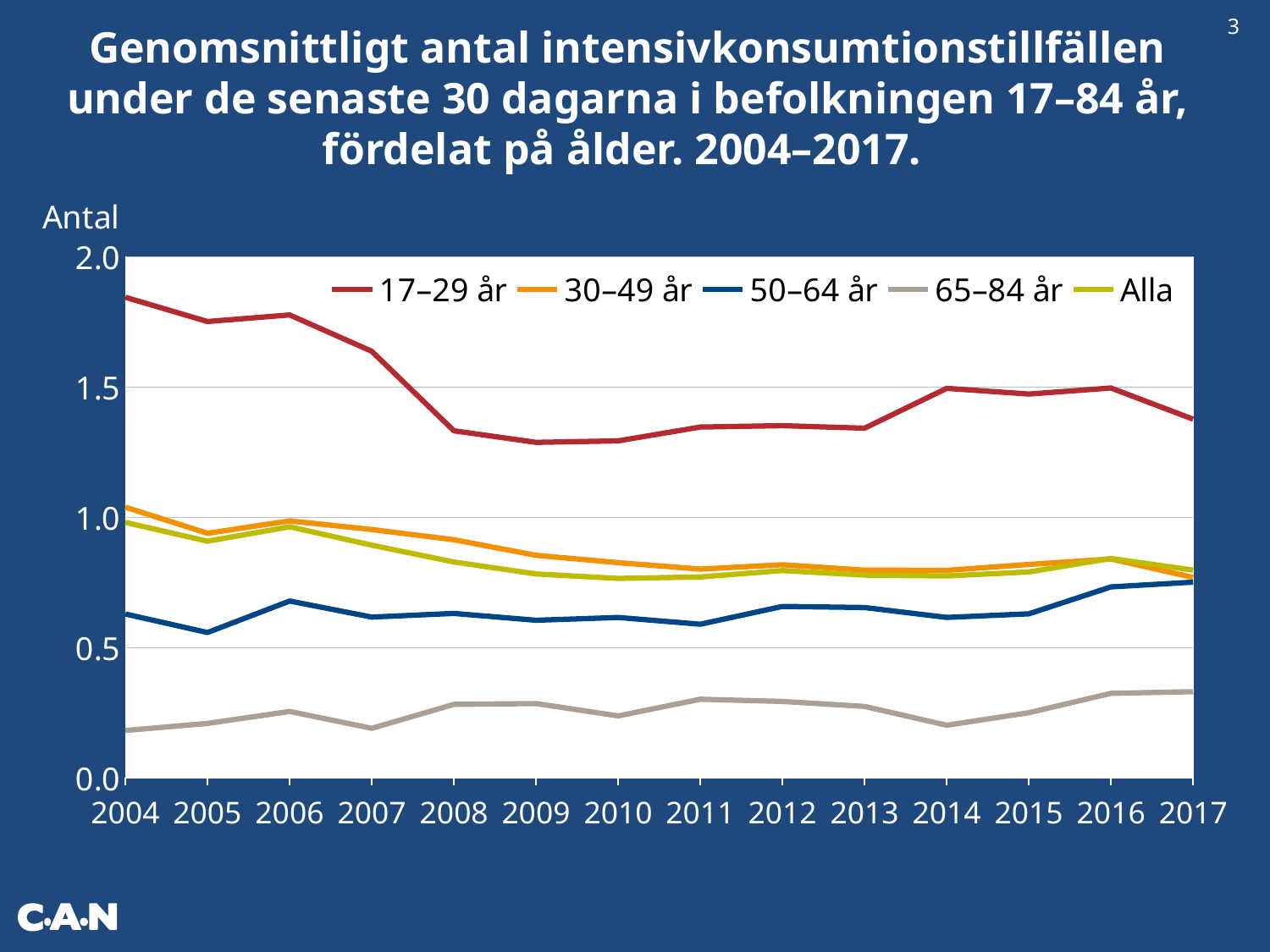
Is the value for 17–29 år in 2009 greater or less than 1.5? less Which age group has the highest value in 2004? 17–29 år What kind of chart is shown on the slide? line chart In 2010, which is larger: the value for 17–29 år or the value for 50–64 år? 17–29 år Is the value for 17–29 år in 2004 greater or less than 1.5? greater In which year does the 17–29 år series reach its highest value? 2004 How many years are plotted along the x axis? 14 How many series does the legend list? 5 Which age group has the lowest value across the whole period? 65–84 år Is the value for 65–84 år in 2004 greater or less than 0.5? less Does the 17–29 år series rise or fall from 2004 to 2009? fall What is the label on the y axis? Antal